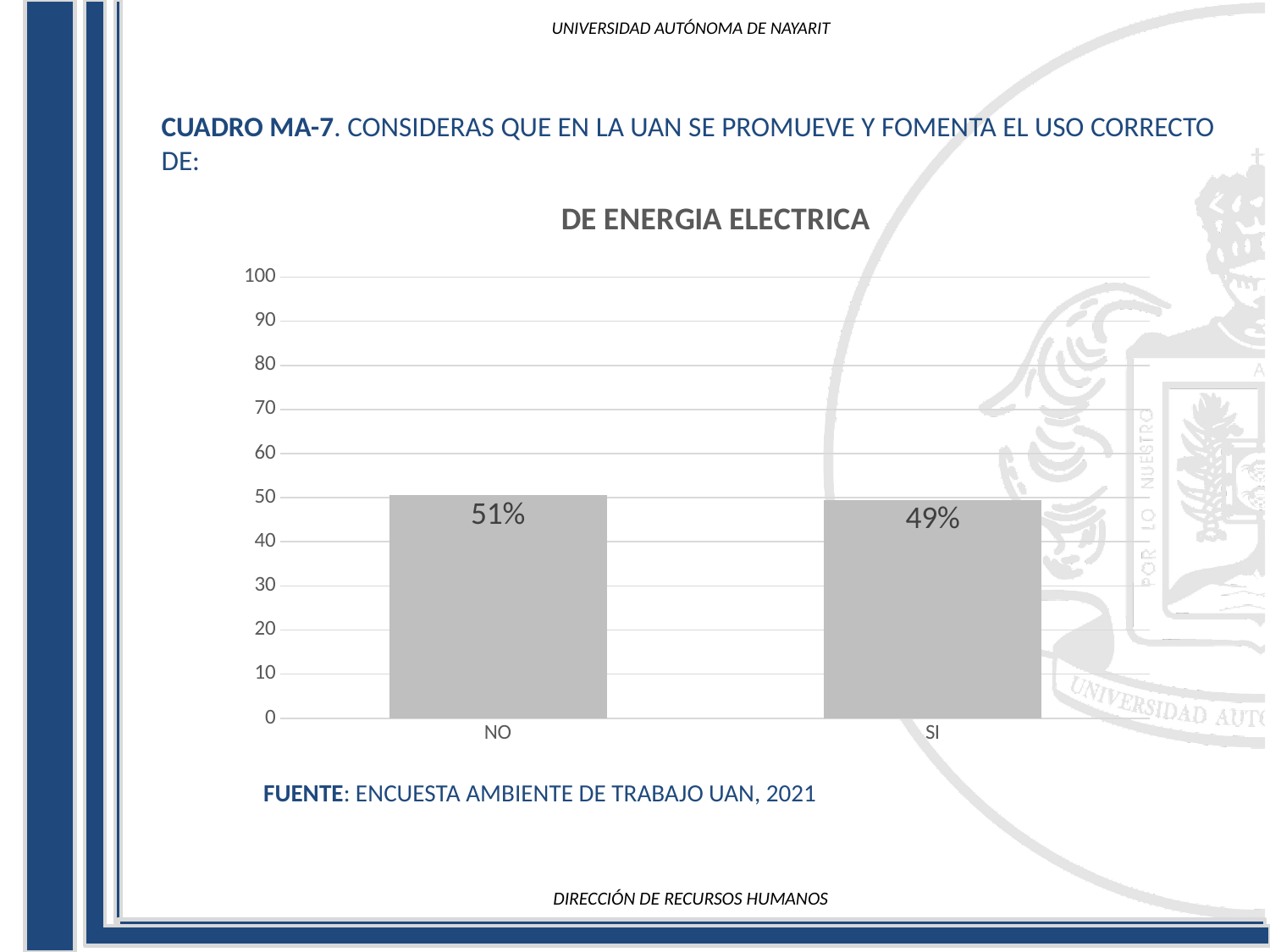
What is the difference between the values for NO and SI? 2% Which category has the lowest value? SI What is the value for SI? 49% Which category has the highest value? NO Is the value for SI greater or less than 50? less How many categories are shown on the x axis? 2 What is the value for NO? 51% What kind of chart is shown? bar chart Is the value for NO greater or less than 40? greater What is the maximum value shown on the y axis? 100 Which is larger, the value for NO or the value for SI? NO What is the title of the chart? DE ENERGIA ELECTRICA